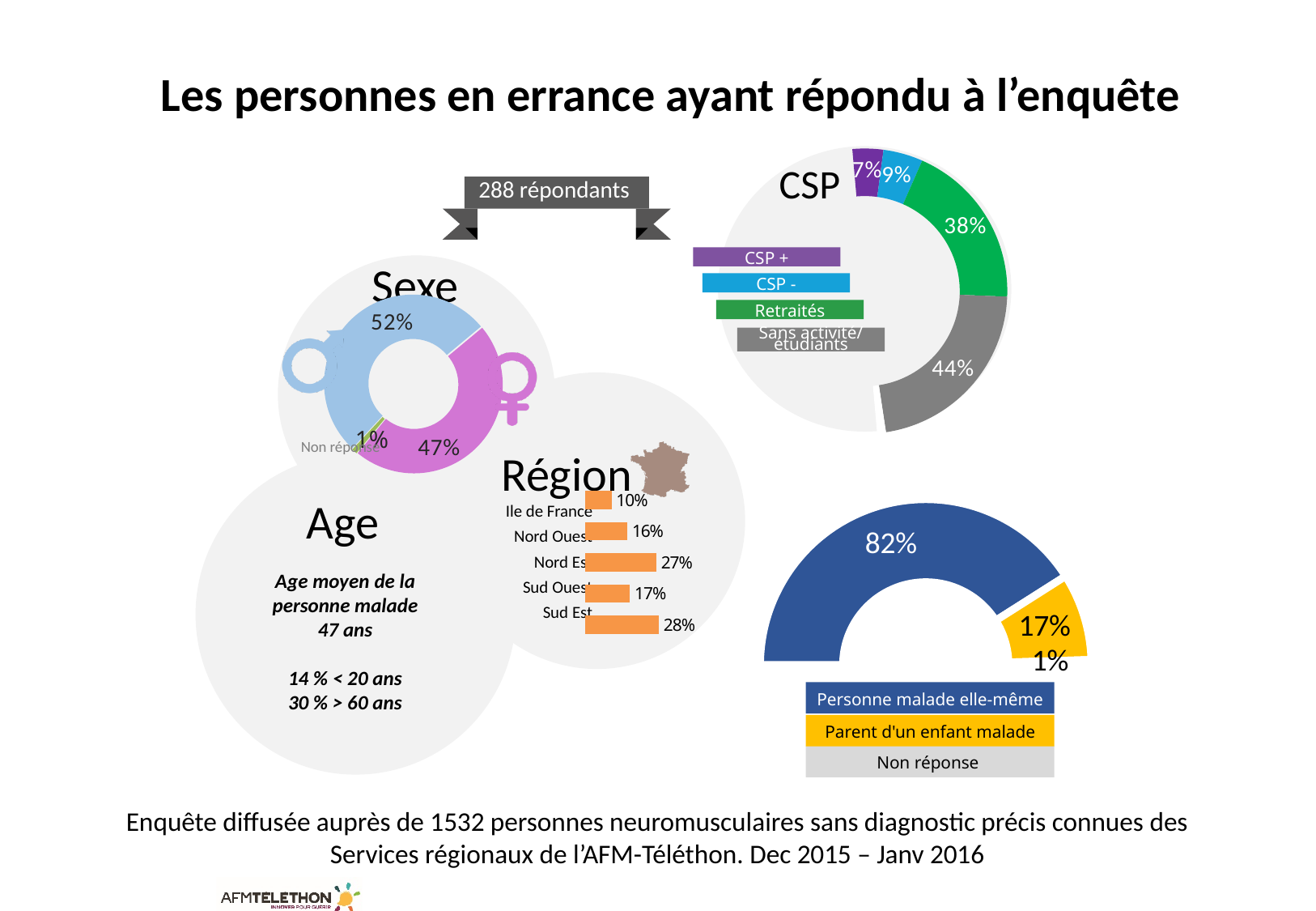
In the Région bar chart, what is the difference between Nord Est and Nord Ouest? 11% What kind of chart is the Région chart? bar chart In the CSP chart, what share is Retraités? 38% In the Région bar chart, how many regions are shown? 5 In the CSP chart, which category has the largest share? Sans activité/étudiants In the Région bar chart, what is the value for Ile de France? 10% In the CSP chart, which is larger, CSP + or CSP -? CSP - In the bottom-right chart, what share is Parent d'un enfant malade? 17% In the Région bar chart, which region has the highest value? Sud Est In the Sexe chart, what share is Non réponse? 1% In the Région bar chart, which region has the lowest value? Ile de France In the Région bar chart, what is the value for Sud Est? 28%